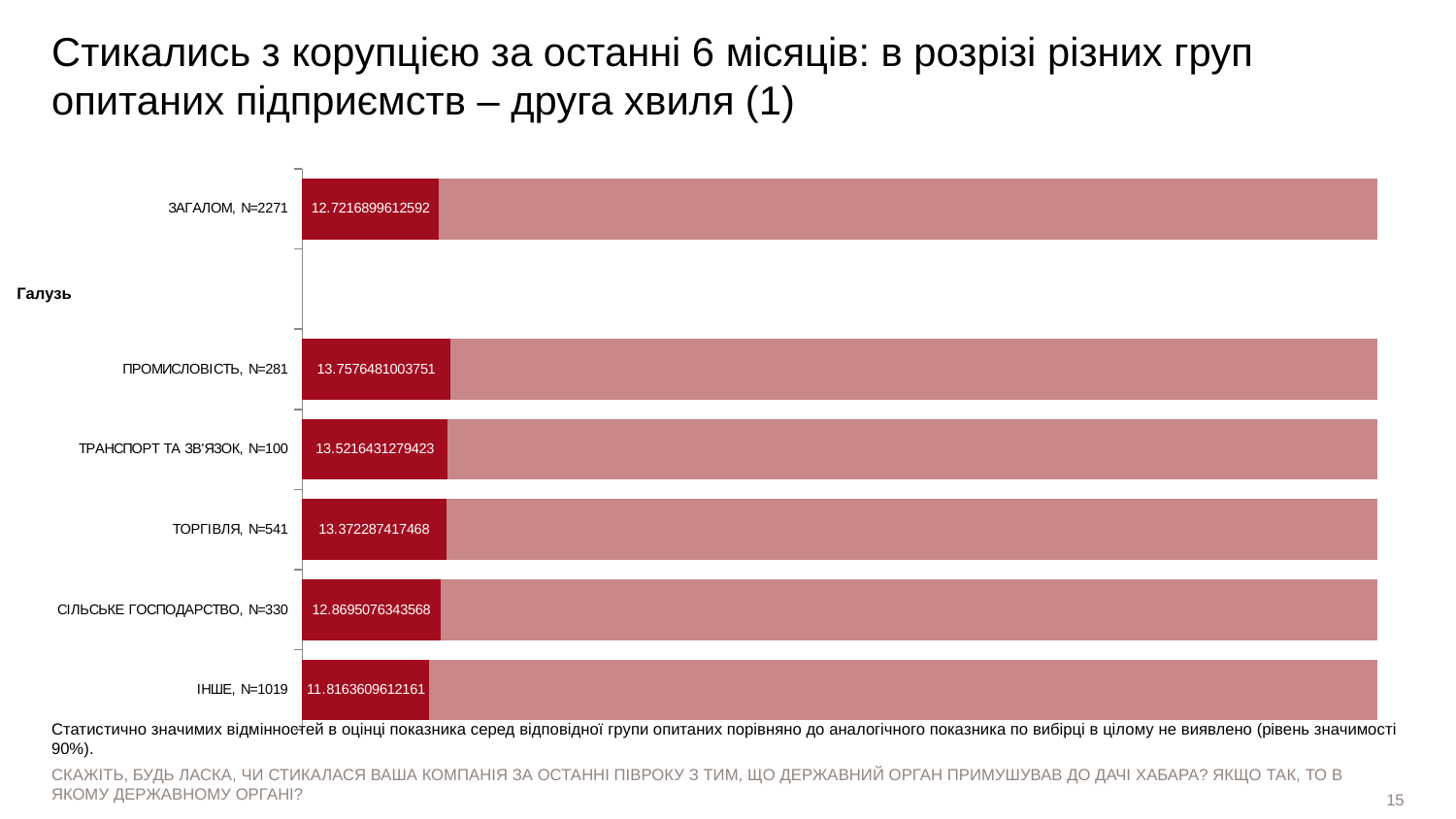
Which has the larger labelled value: ТОРГІВЛЯ, N=541 or ІНШЕ, N=1019? ТОРГІВЛЯ, N=541 What is the value shown for ТРАНСПОРТ ТА ЗВ'ЯЗОК, N=100? 13.5216431279423 Which category has the lowest labelled value? ІНШЕ, N=1019 What is the value shown for ЗАГАЛОМ, N=2271? 12.7216899612592 What is the value shown for ПРОМИСЛОВІСТЬ, N=281? 13.7576481003751 What is the value shown for ІНШЕ, N=1019? 11.8163609612161 What kind of chart is shown on the slide? Bar chart What colour is the segment of each bar that carries the data label? Dark red How many categories have a labelled bar on the chart? 6 What is the value shown for ТОРГІВЛЯ, N=541? 13.372287417468 Which category has the highest labelled value? ПРОМИСЛОВІСТЬ, N=281 What is the value shown for СІЛЬСЬКЕ ГОСПОДАРСТВО, N=330? 12.8695076343568